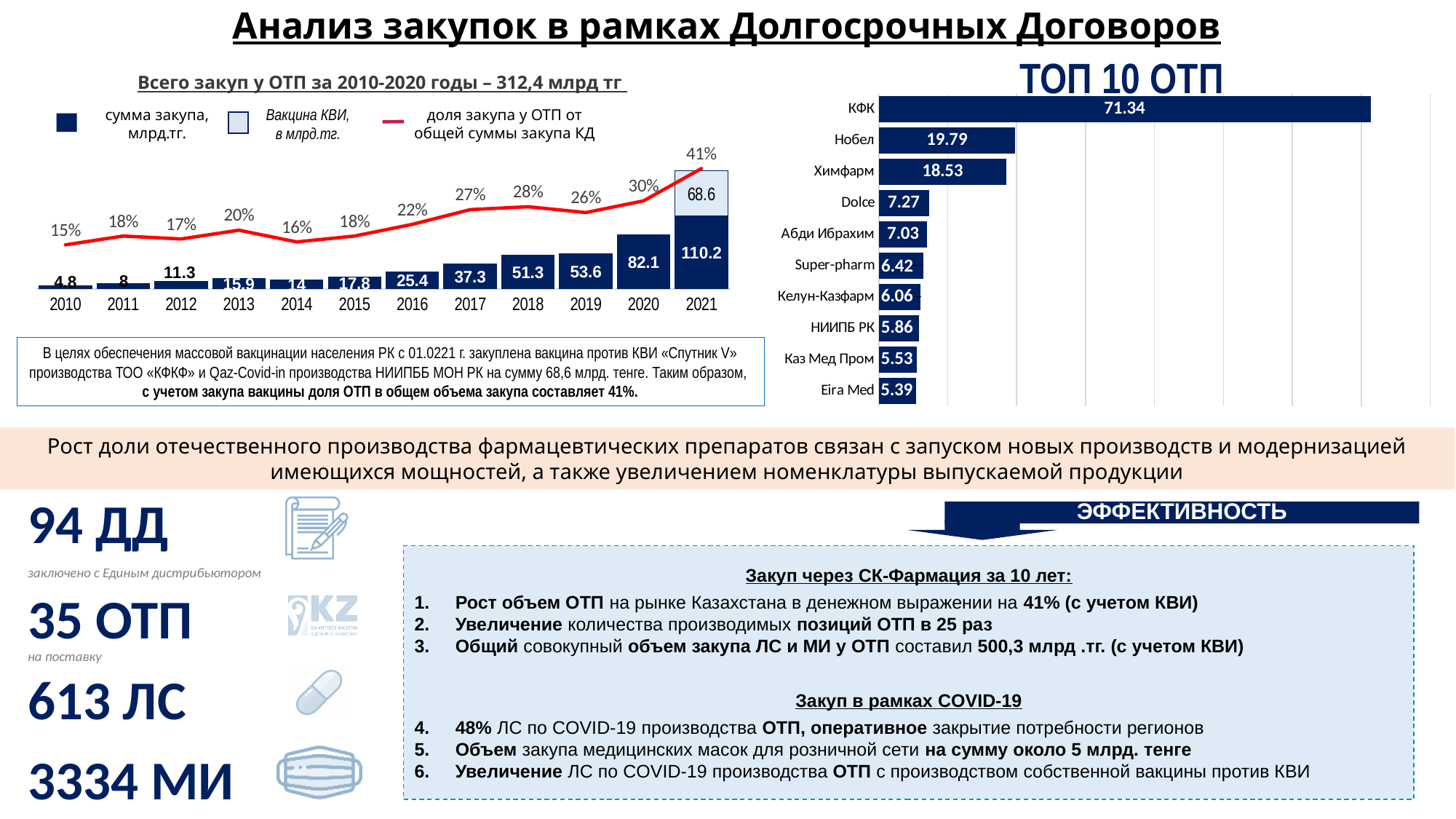
How many companies are shown in the 'ТОП 10 ОТП' chart? 10 In the 'ТОП 10 ОТП' chart, which company has the lowest value? Eira Med How many series does the legend of the left chart 'Всего закуп у ОТП за 2010-2020 годы' list? 3 What kind of chart is the 'ТОП 10 ОТП' chart? Bar chart In the left chart 'Всего закуп у ОТП за 2010-2020 годы', what is the purchase amount (сумма закупа) for 2020? 82.1 In the left chart 'Всего закуп у ОТП за 2010-2020 годы', what is the share of purchases from ОТП (доля закупа) in 2017? 27% In the 'ТОП 10 ОТП' chart, which company has the highest value? КФК In the left chart 'Всего закуп у ОТП за 2010-2020 годы', which year has the larger purchase amount, 2013 or 2014? 2013 In the 'ТОП 10 ОТП' chart, what is the value for Химфарм? 18.53 In the left chart 'Всего закуп у ОТП за 2010-2020 годы', what is the total of the stacked bar for 2021 (сумма закупа plus Вакцина КВИ)? 178.8 In the 'ТОП 10 ОТП' chart, what is the difference between the values for КФК and Нобел? 51.55 In the left chart 'Всего закуп у ОТП за 2010-2020 годы', does the share line (доля закупа у ОТП) rise or fall from 2019 to 2021? Rises